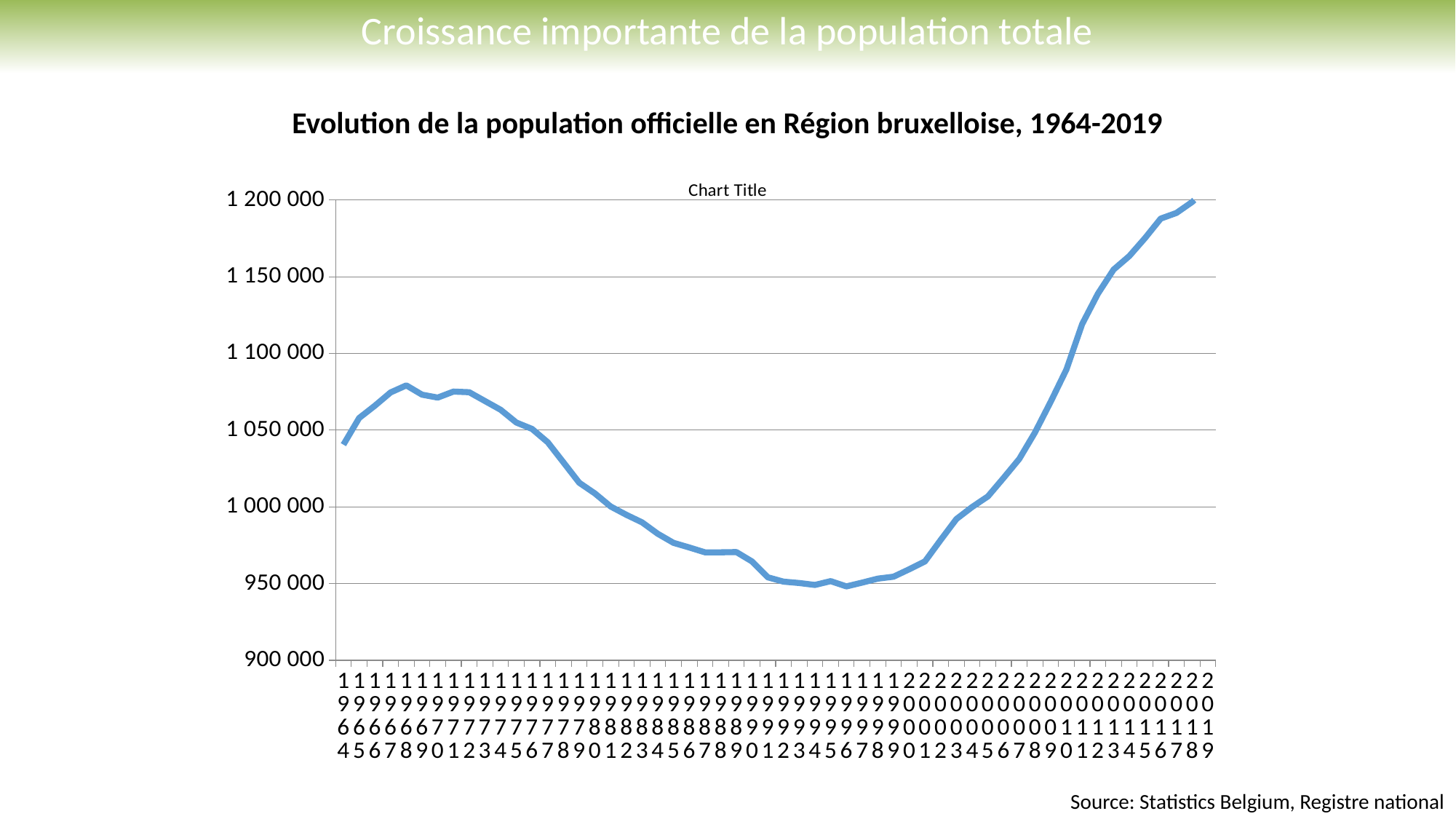
What kind of chart is shown on the slide? line chart Is the value for 1964 greater or less than 1 050 000? less What is the title printed above the chart? Evolution de la population officielle en Région bruxelloise, 1964-2019 Which year has the highest population value on the chart? 2019 Is the value for 1985 greater or less than 1 000 000? less Is the value for 2015 greater or less than 1 150 000? greater Does the population rise or fall between 2000 and 2019? rise What source is cited for the chart? Statistics Belgium, Registre national Which is larger, the value for 1970 or the value for 1990? 1970 How many years (data points) are plotted along the x axis? 56